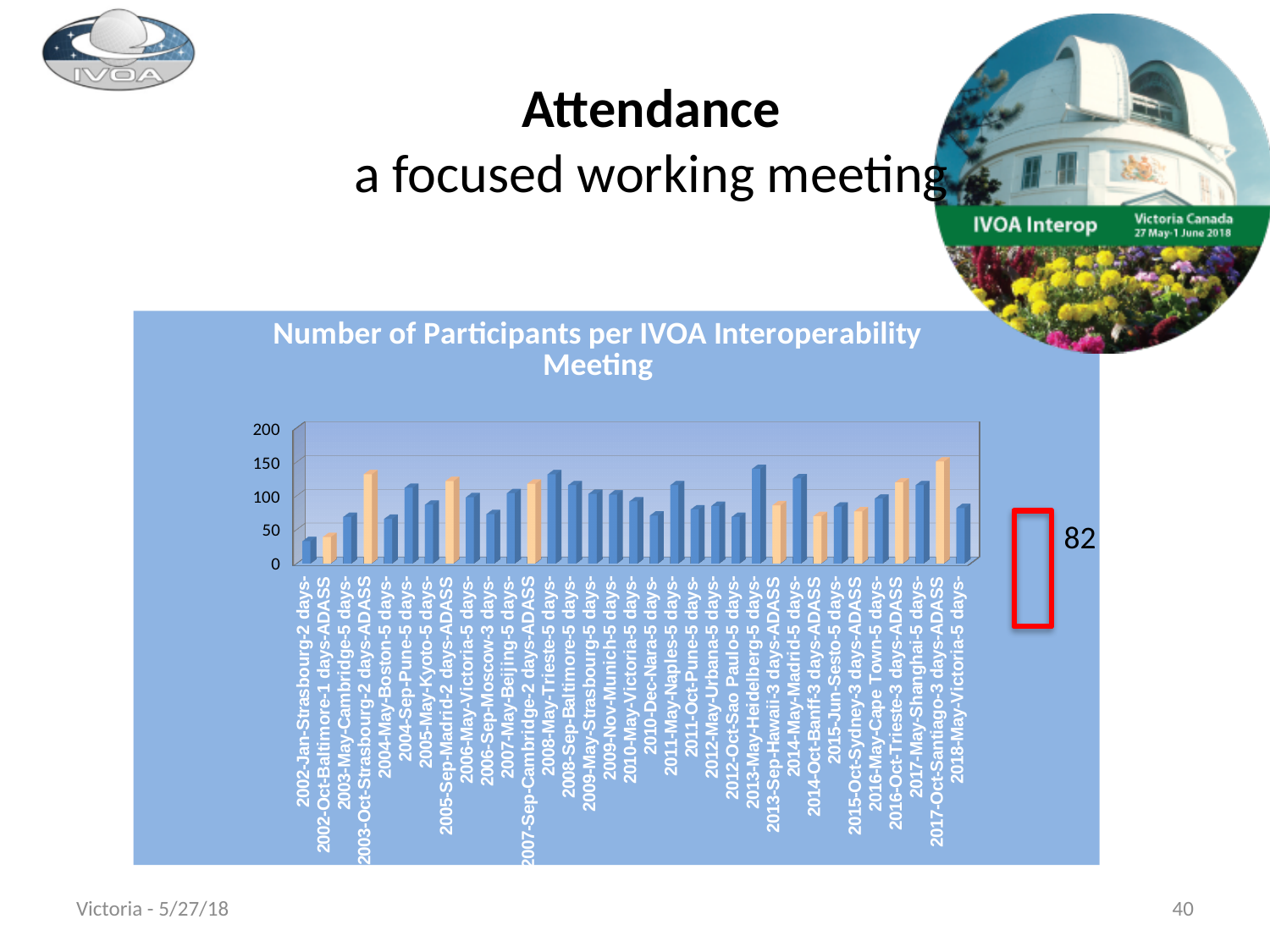
What is the title of the chart? Number of Participants per IVOA Interoperability Meeting Is the value for 2002-Jan-Strasbourg-2 days greater or less than 50? less Which meeting has the lowest number of participants? 2002-Jan-Strasbourg-2 days What kind of chart is shown on the slide? Bar chart Is the value for 2004-May-Boston-5 days greater or less than 100? less Is the value for 2003-Oct-Strasbourg-2 days-ADASS greater or less than 100? greater What is the number of participants for the 2018-May-Victoria-5 days meeting? 82 How many meetings are shown on the x axis of the chart? 33 Which has more participants, 2013-May-Heidelberg-5 days or 2012-Oct-Sao Paulo-5 days? 2013-May-Heidelberg-5 days Which has more participants, 2003-Oct-Strasbourg-2 days-ADASS or 2004-May-Boston-5 days? 2003-Oct-Strasbourg-2 days-ADASS